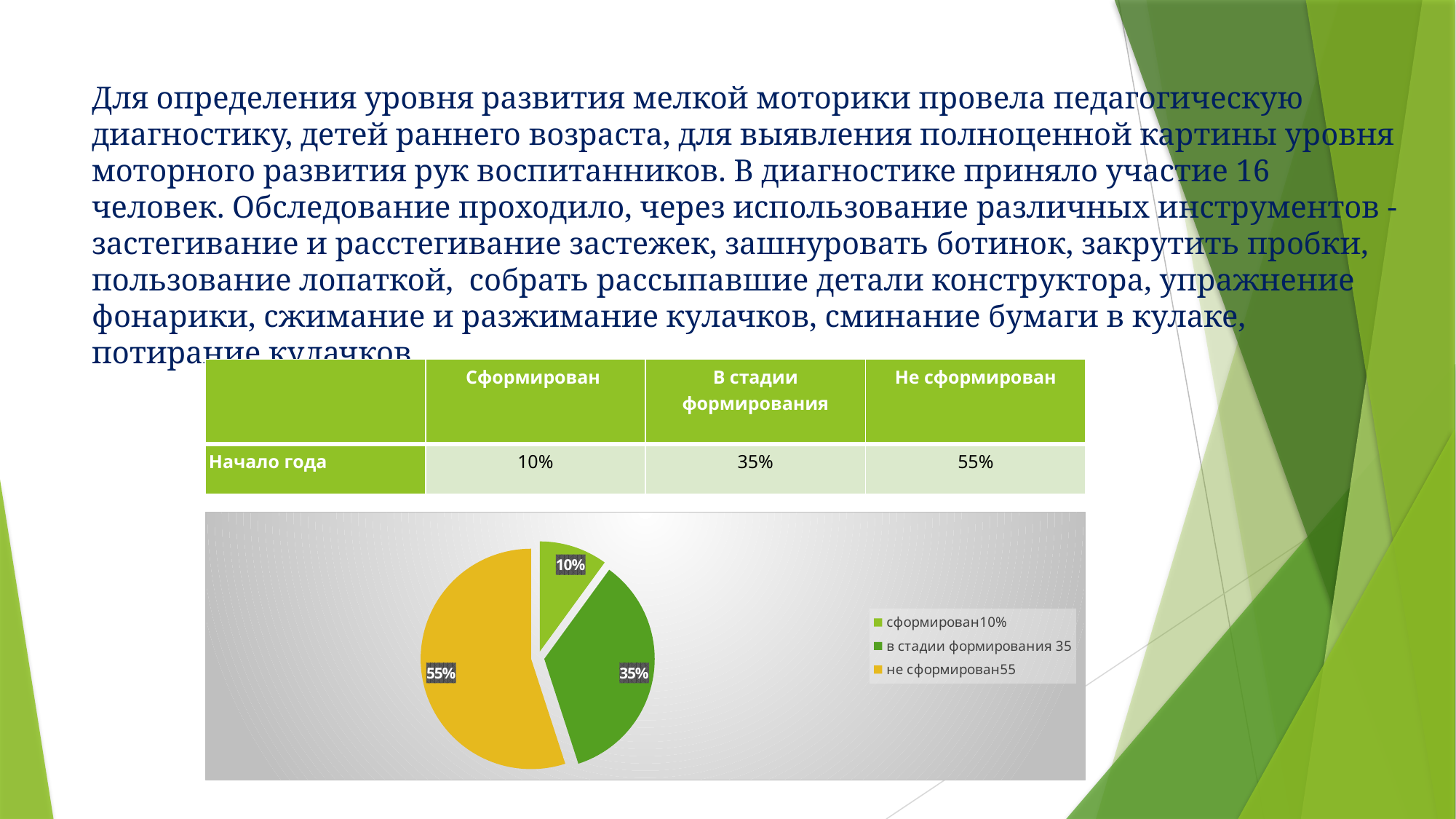
How many entries does the legend of the pie chart list? 3 What is the difference between the 'не сформирован' and 'в стадии формирования' slices of the pie chart? 20% What is the value shown for the 'сформирован' slice of the pie chart? 10% What is the value shown for the 'в стадии формирования' slice of the pie chart? 35% Which slice of the pie chart is the largest? не сформирован What colour is the 'не сформирован' slice in the pie chart? yellow How many slices does the pie chart have? 3 What is the difference between the 'в стадии формирования' and 'сформирован' slices of the pie chart? 25% What kind of chart is shown on the slide? pie chart Which is larger in the pie chart: 'сформирован' or 'в стадии формирования'? в стадии формирования Which slice of the pie chart is the smallest? сформирован What is the value shown for the 'не сформирован' slice of the pie chart? 55%